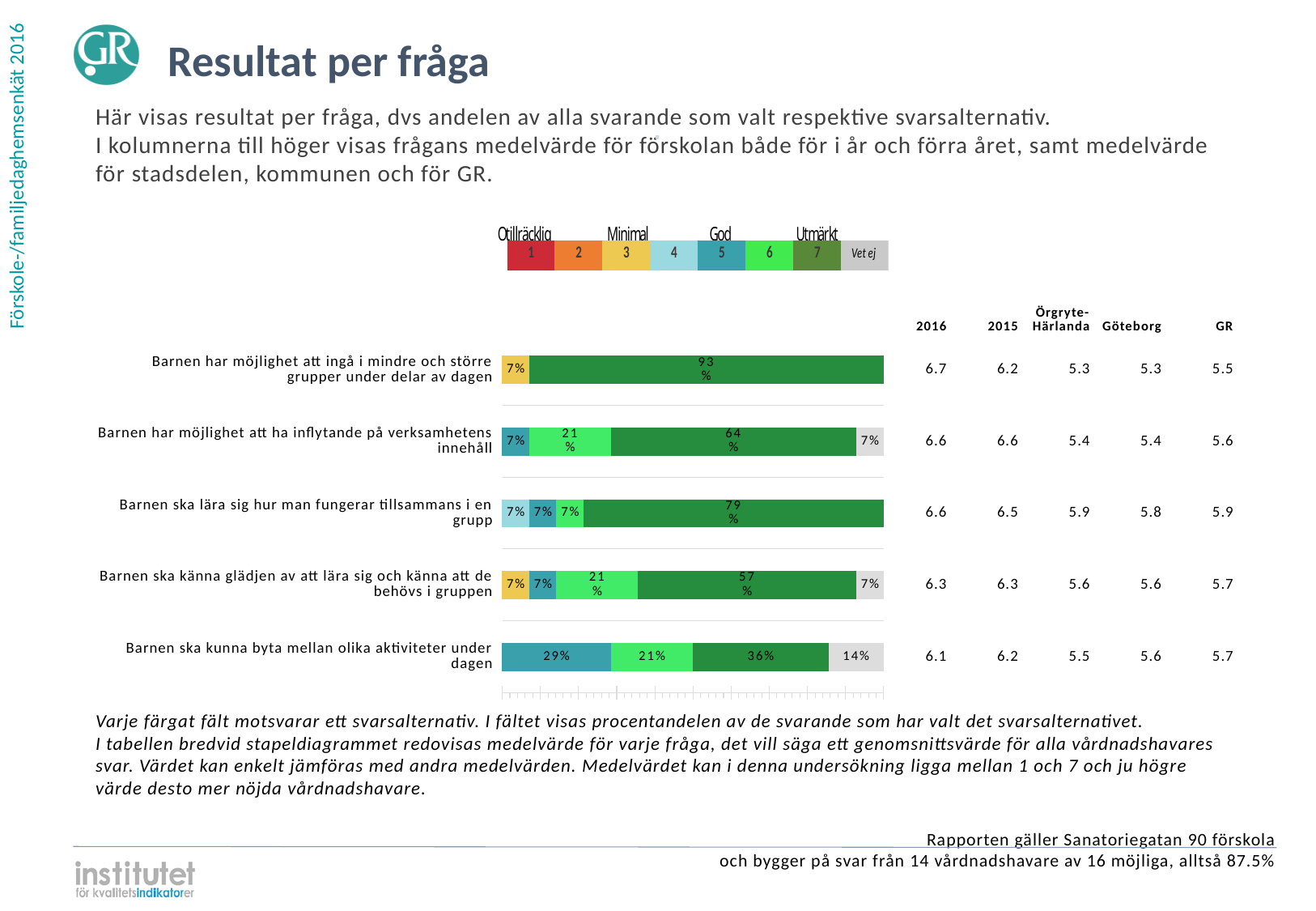
What is the 'Vet ej' share for 'Barnen ska kunna byta mellan olika aktiviteter under dagen'? 14% What percentage chose answer 7 for 'Barnen ska känna glädjen av att lära sig och känna att de behövs i gruppen'? 57% What label does the legend give to answer alternative 7? Utmärkt How many answer alternatives does the legend above the chart list? 8 What kind of chart is shown on the slide? Stacked bar chart How many questions (categories) are plotted in the bar chart? 5 What is the total of all segments in the bar for 'Barnen ska kunna byta mellan olika aktiviteter under dagen'? 100% What is the difference between the answer 7 share for 'Barnen har möjlighet att ingå i mindre och större grupper under delar av dagen' (93%) and for 'Barnen ska lära sig hur man fungerar tillsammans i en grupp' (79%)? 14 percentage points What percentage chose answer 7 for 'Barnen har möjlighet att ha inflytande på verksamhetens innehåll'? 64% For 'Barnen ska kunna byta mellan olika aktiviteter under dagen', which is larger: the share for answer 5 or the share for answer 6? Answer 5 (29%) Which question has the largest share of answer 7 (dark green)? Barnen har möjlighet att ingå i mindre och större grupper under delar av dagen What percentage chose answer 7 for 'Barnen ska kunna byta mellan olika aktiviteter under dagen'? 36%